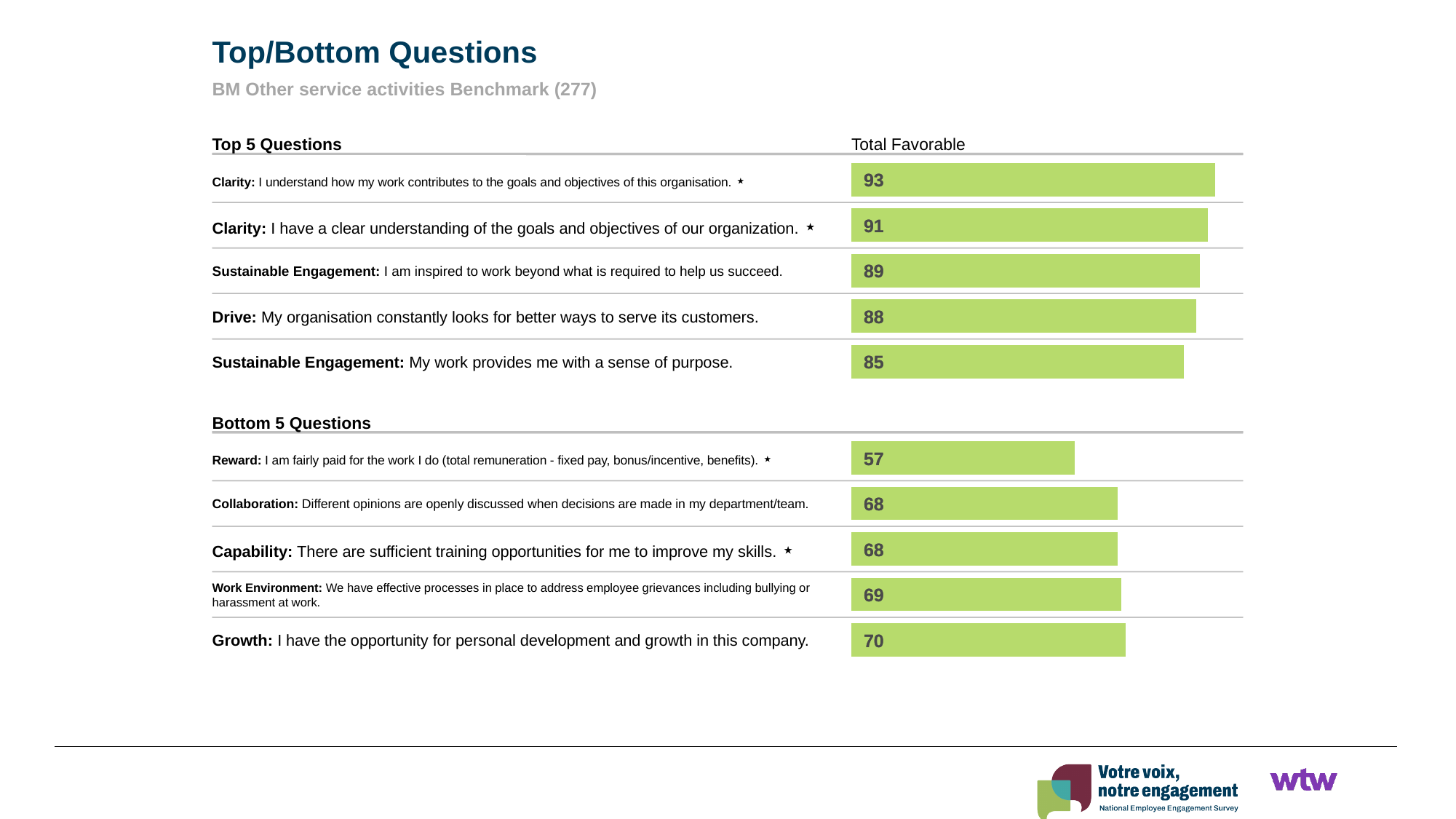
In the Top 5 Questions chart, what is the difference between the highest value (93) and the lowest value (85)? 8 What type of chart is used to show the Total Favorable values on this slide? Bar chart In the Bottom 5 Questions chart, which question has the lowest Total Favorable value? Reward: I am fairly paid for the work I do (total remuneration - fixed pay, bonus/incentive, benefits). In the Bottom 5 Questions chart, which question has the highest Total Favorable value? Growth: I have the opportunity for personal development and growth in this company. How many questions are shown in the Bottom 5 Questions chart? 5 In the Bottom 5 Questions chart, what is the Total Favorable value for "Growth: I have the opportunity for personal development and growth in this company."? 70 In the Top 5 Questions chart, which question has the lowest Total Favorable value? Sustainable Engagement: My work provides me with a sense of purpose. In the Bottom 5 Questions chart, what is the Total Favorable value for "Reward: I am fairly paid for the work I do"? 57 Which is larger: the Total Favorable for "Sustainable Engagement: I am inspired to work beyond what is required to help us succeed." or for "Drive: My organisation constantly looks for better ways to serve its customers."? Sustainable Engagement: I am inspired to work beyond what is required to help us succeed. In the Top 5 Questions chart, what is the Total Favorable value for "Drive: My organisation constantly looks for better ways to serve its customers."? 88 In the Bottom 5 Questions chart, what is the difference between the Growth value and the Reward value? 13 In the Top 5 Questions chart, what is the Total Favorable value for "Clarity: I understand how my work contributes to the goals and objectives of this organisation."? 93